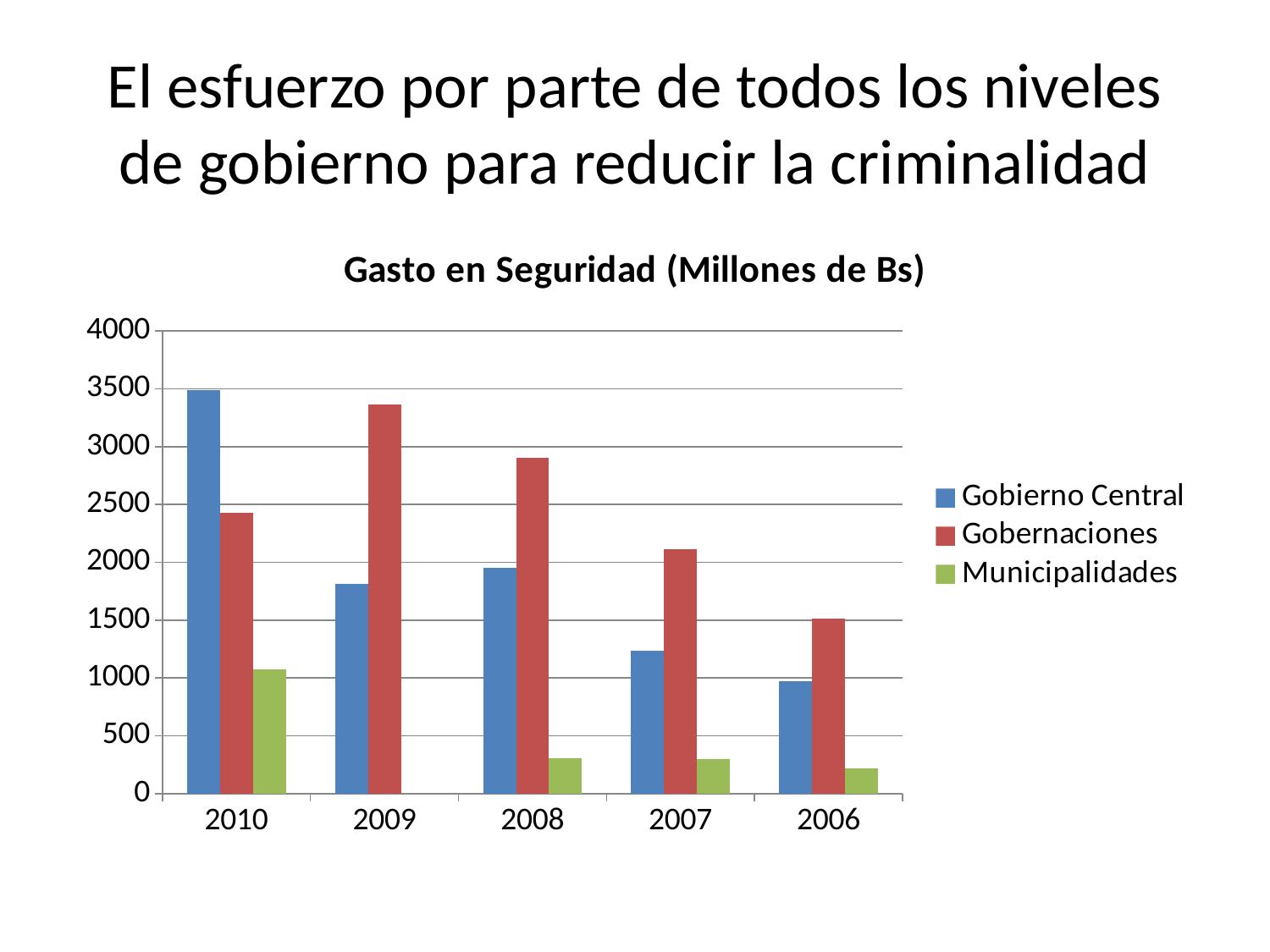
How many series does the legend list? 3 In which year is the Gobierno Central value lowest? 2006 In which year is the Municipalidades value highest? 2010 In 2008, which is larger: Gobierno Central or Gobernaciones? Gobernaciones What kind of chart is shown on the slide? bar chart In which year is the Gobierno Central value highest? 2010 In which year is the Gobernaciones value highest? 2009 How many years are shown on the x axis? 5 In which year is the Gobernaciones value lowest? 2006 Is the value for Gobierno Central in 2010 greater or less than 3000? greater Is the value for Gobernaciones in 2007 greater or less than 2500? less What is the title of the chart? Gasto en Seguridad (Millones de Bs)